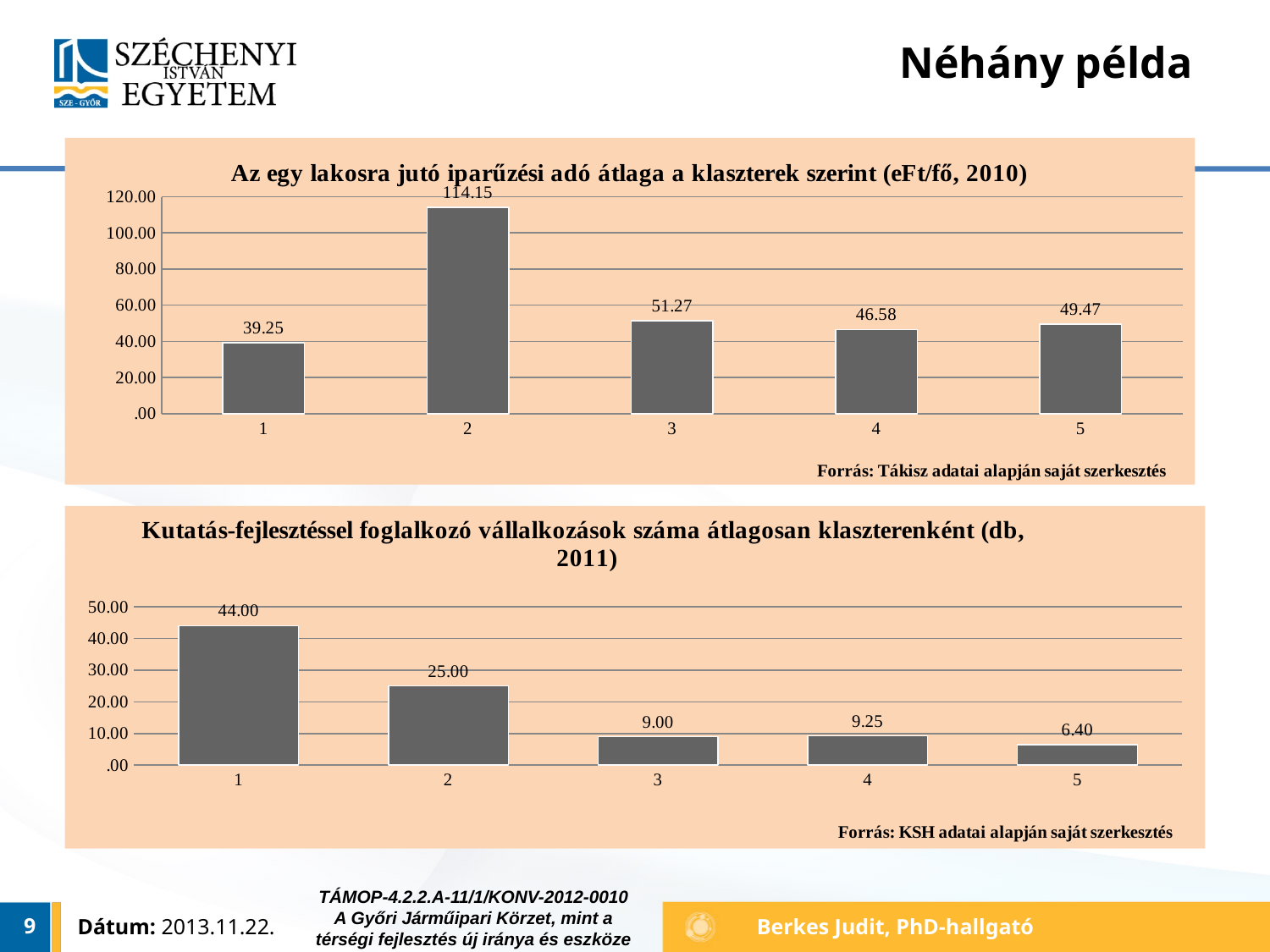
In the top chart (Az egy lakosra jutó iparűzési adó átlaga a klaszterek szerint), how many clusters are shown on the x axis? 5 In the bottom chart (Kutatás-fejlesztéssel foglalkozó vállalkozások száma átlagosan klaszterenként), what is the difference between the values for cluster 1 and cluster 2? 19.00 In the top chart (Az egy lakosra jutó iparűzési adó átlaga a klaszterek szerint), which is larger, the value for cluster 3 or cluster 4? cluster 3 In the bottom chart (Kutatás-fejlesztéssel foglalkozó vállalkozások száma átlagosan klaszterenként), which cluster has the lowest value? 5 In the bottom chart (Kutatás-fejlesztéssel foglalkozó vállalkozások száma átlagosan klaszterenként), what is the value for cluster 1? 44.00 In the top chart (Az egy lakosra jutó iparűzési adó átlaga a klaszterek szerint), what is the value for cluster 2? 114.15 In the bottom chart (Kutatás-fejlesztéssel foglalkozó vállalkozások száma átlagosan klaszterenként), which cluster has the highest value? 1 What kind of chart is the top chart (Az egy lakosra jutó iparűzési adó átlaga a klaszterek szerint)? bar chart In the top chart (Az egy lakosra jutó iparűzési adó átlaga a klaszterek szerint), what is the difference between the values for cluster 2 and cluster 1? 74.90 In the bottom chart (Kutatás-fejlesztéssel foglalkozó vállalkozások száma átlagosan klaszterenként), is the value for cluster 2 greater or less than 20.00? greater In the top chart (Az egy lakosra jutó iparűzési adó átlaga a klaszterek szerint), which cluster has the lowest value? 1 According to the source note under the bottom chart, whose data is the chart based on? KSH